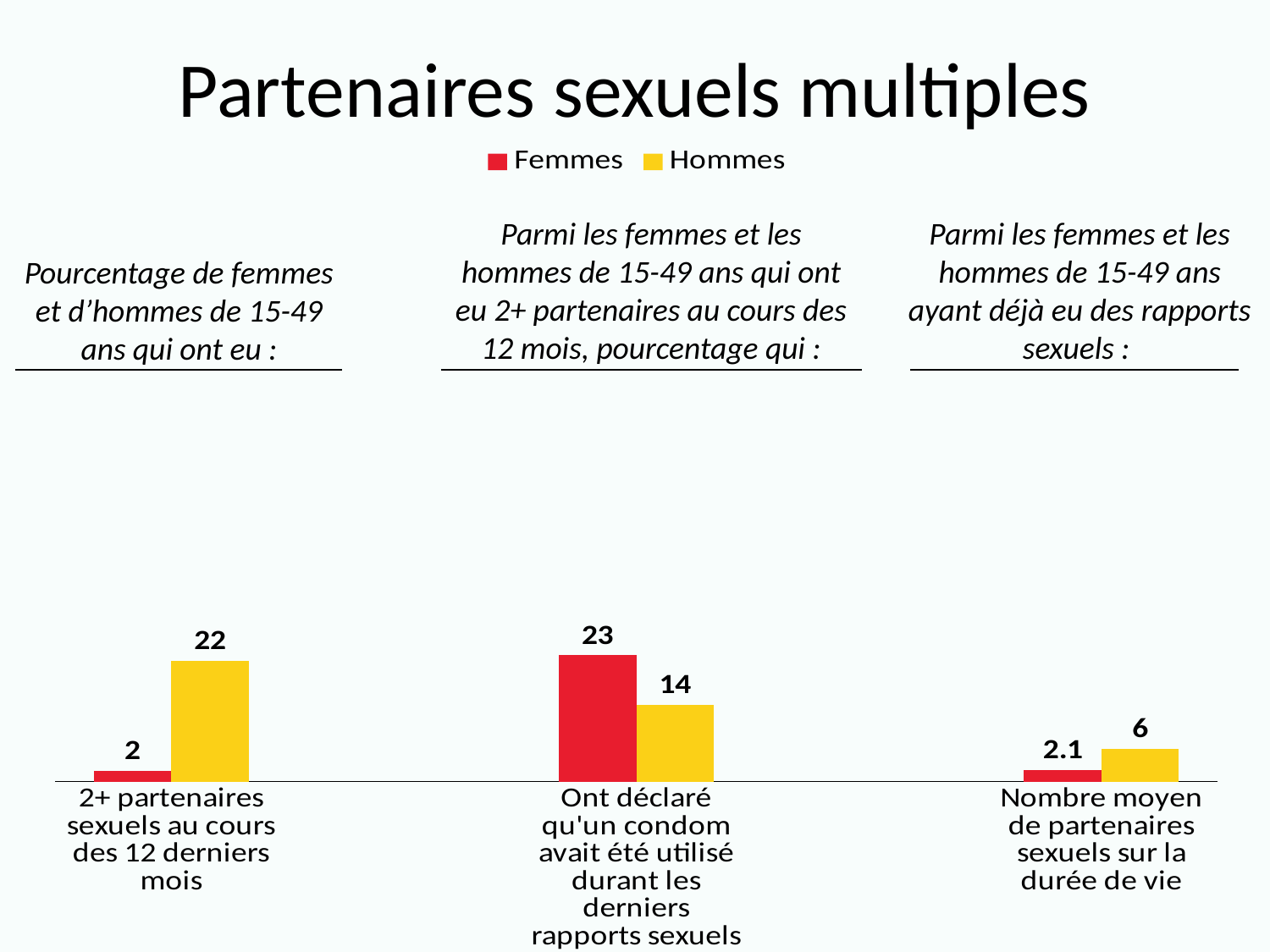
What is the difference between the Hommes and Femmes values in the category "2+ partenaires sexuels au cours des 12 derniers mois"? 20 How many categories are shown on the x axis of the chart? 3 What kind of chart is shown on the slide? Bar chart What is the value for Femmes in the category "Nombre moyen de partenaires sexuels sur la durée de vie"? 2.1 Which category has the highest value for Femmes? Ont déclaré qu'un condom avait été utilisé durant les derniers rapports sexuels What is the value for Hommes in the category "2+ partenaires sexuels au cours des 12 derniers mois"? 22 How many series does the legend list? 2 What is the value for Femmes in the category "Ont déclaré qu'un condom avait été utilisé durant les derniers rapports sexuels"? 23 What is the value for Hommes in the category "Nombre moyen de partenaires sexuels sur la durée de vie"? 6 Which category has the lowest value for Hommes? Nombre moyen de partenaires sexuels sur la durée de vie What is the difference between the Femmes and Hommes values in the category "Ont déclaré qu'un condom avait été utilisé durant les derniers rapports sexuels"? 9 In the category "Ont déclaré qu'un condom avait été utilisé durant les derniers rapports sexuels", which series has the larger value, Femmes or Hommes? Femmes